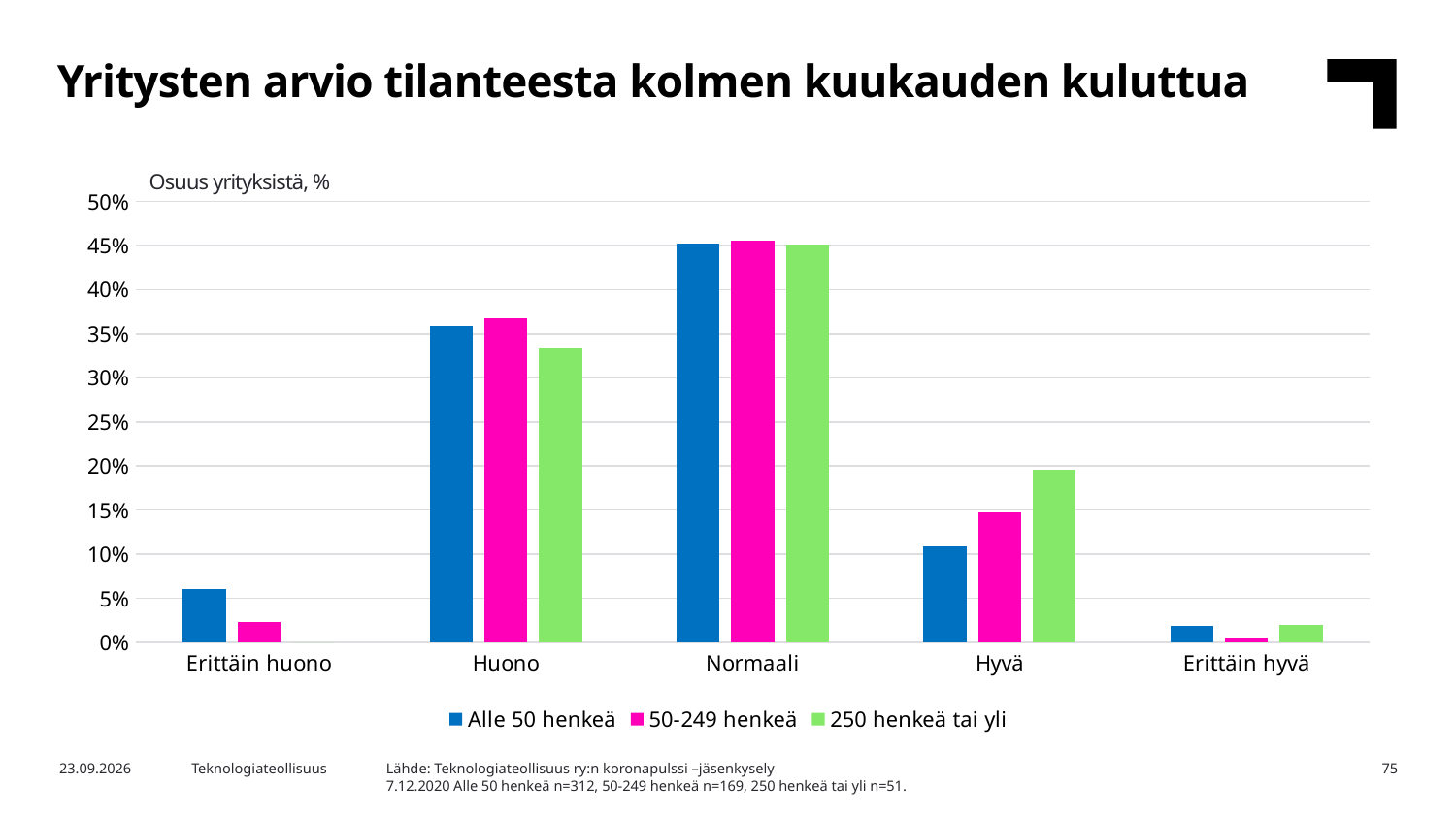
Which category has the lowest value for 250 henkeä tai yli? Erittäin huono What kind of chart is shown on the slide? bar chart Is the value for Alle 50 henkeä in the Normaali category greater or less than 40%? greater Is the value for Alle 50 henkeä in the Hyvä category greater or less than 15%? less Is the value for 250 henkeä tai yli in the Hyvä category greater or less than 15%? greater In the Erittäin huono category, which is larger: Alle 50 henkeä or 50-249 henkeä? Alle 50 henkeä How many categories are shown on the x axis? 5 In the Hyvä category, which is larger: Alle 50 henkeä or 250 henkeä tai yli? 250 henkeä tai yli What are the three series listed in the legend? Alle 50 henkeä, 50-249 henkeä, 250 henkeä tai yli Which category has the highest value for Alle 50 henkeä? Normaali How many series does the legend list? 3